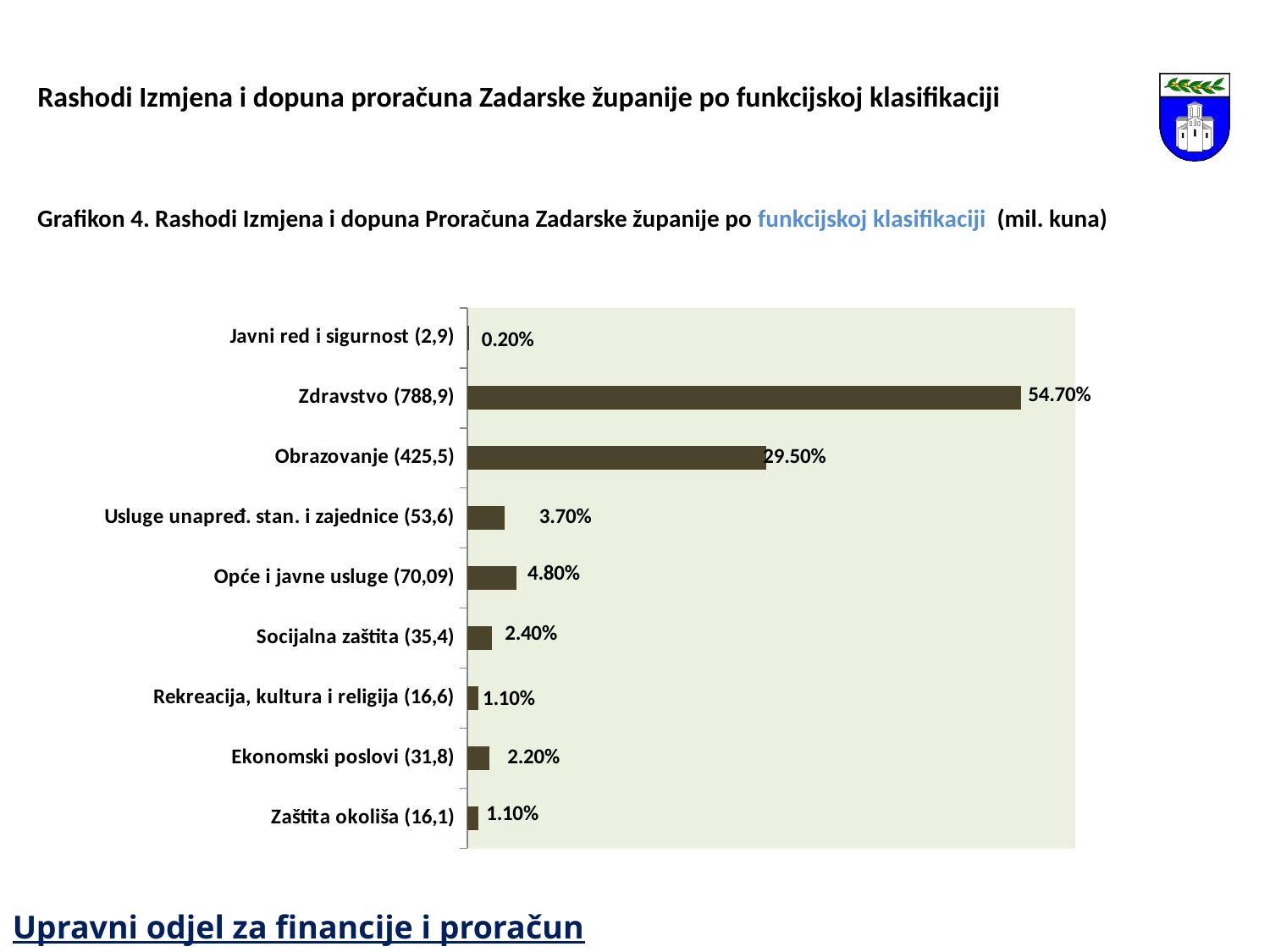
Which category has the lowest percentage? Javni red i sigurnost (2,9) How many categories are plotted in the chart? 9 What is the difference in percentage points between Opće i javne usluge (70,09) and Usluge unapređ. stan. i zajednice (53,6)? 1.10% What kind of chart is shown on the slide? bar chart What percentage is shown for Obrazovanje (425,5)? 29.50% What percentage is shown for Opće i javne usluge (70,09)? 4.80% Which has the larger percentage, Ekonomski poslovi (31,8) or Socijalna zaštita (35,4)? Socijalna zaštita (35,4) Which category has the highest percentage? Zdravstvo (788,9) What is the difference in percentage points between Zdravstvo (788,9) and Obrazovanje (425,5)? 25.20% What unit is stated in parentheses in the chart caption 'Grafikon 4'? mil. kuna What percentage is shown for Zdravstvo (788,9)? 54.70% What percentage is shown for Socijalna zaštita (35,4)? 2.40%